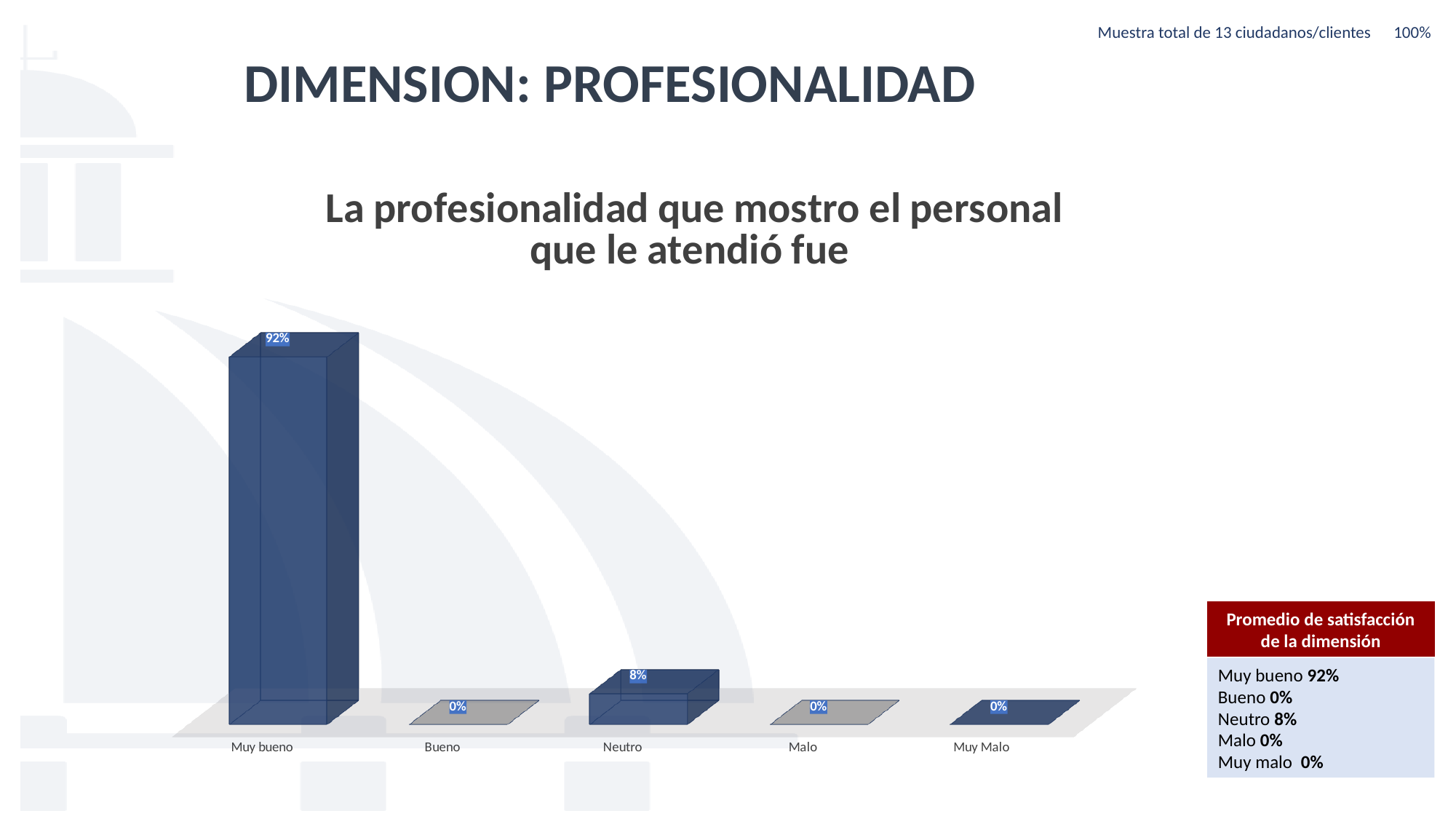
Which category has the highest value? Muy bueno Which is larger, the value for Neutro or the value for Malo? Neutro What is the title of the chart? La profesionalidad que mostro el personal que le atendió fue What is the value for Neutro? 8% How many categories have a value of 0%? 3 What kind of chart is shown on the slide? Bar chart What is the difference between the values for Muy bueno and Neutro? 84% What is the value for Bueno? 0% How many categories are shown on the x axis? 5 What is the total sample size stated on the slide? 13 ciudadanos/clientes What is the value for Muy bueno? 92% What is the value for Muy Malo? 0%